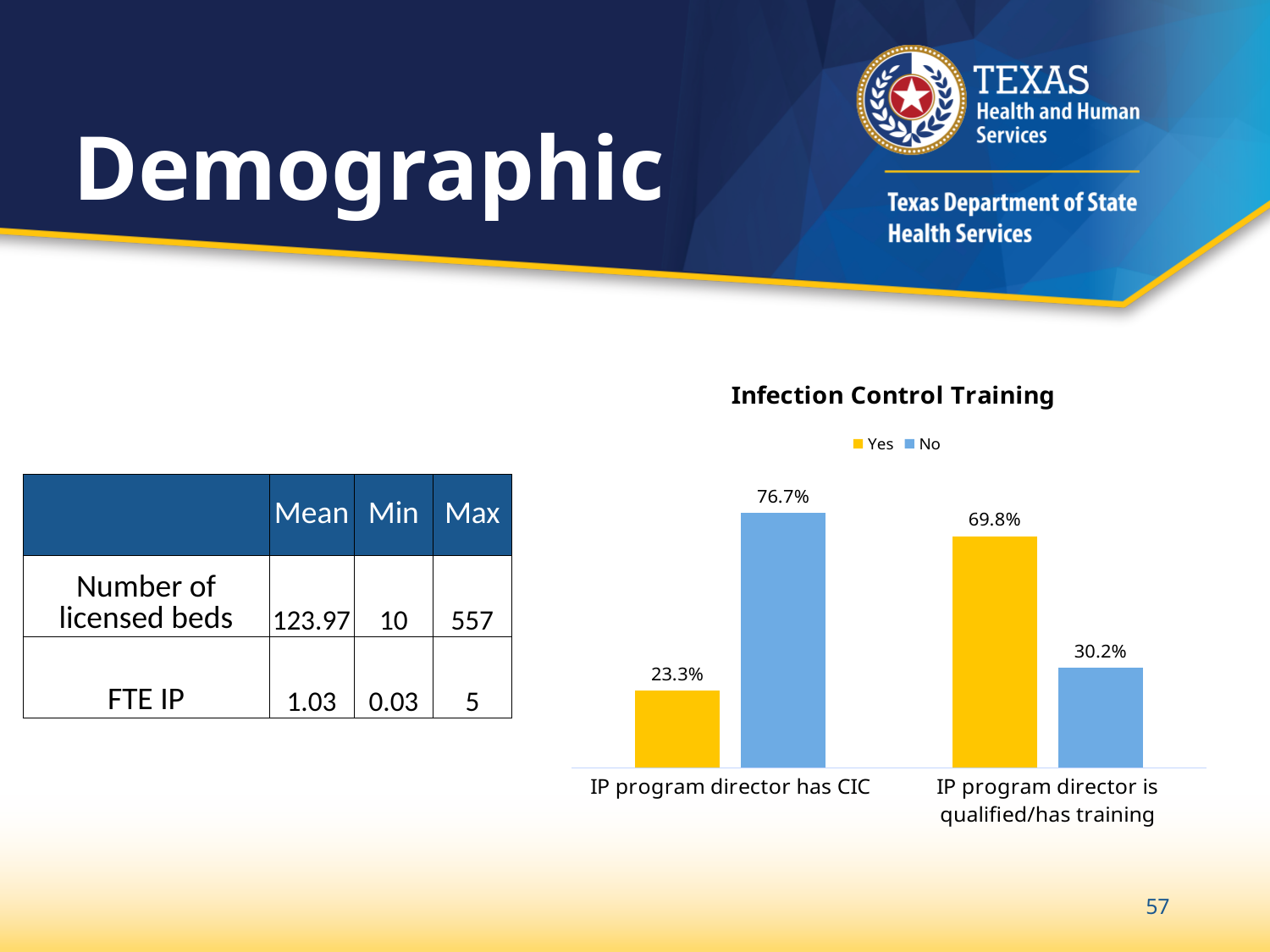
What is the 'Yes' value for 'IP program director has CIC'? 23.3% How many series does the chart legend list? 2 What is the 'No' value for 'IP program director has CIC'? 76.7% What is the 'Yes' value for 'IP program director is qualified/has training'? 69.8% What is the title of the chart? Infection Control Training Which bar in the chart has the lowest value? Yes for IP program director has CIC How many categories are shown on the x axis of the chart? 2 Which is larger for 'IP program director is qualified/has training', the 'Yes' value or the 'No' value? Yes Which bar in the chart has the highest value? No for IP program director has CIC What is the 'No' value for 'IP program director is qualified/has training'? 30.2% What kind of chart is shown on the slide? bar chart What is the difference between the 'No' and 'Yes' values for 'IP program director has CIC'? 53.4%